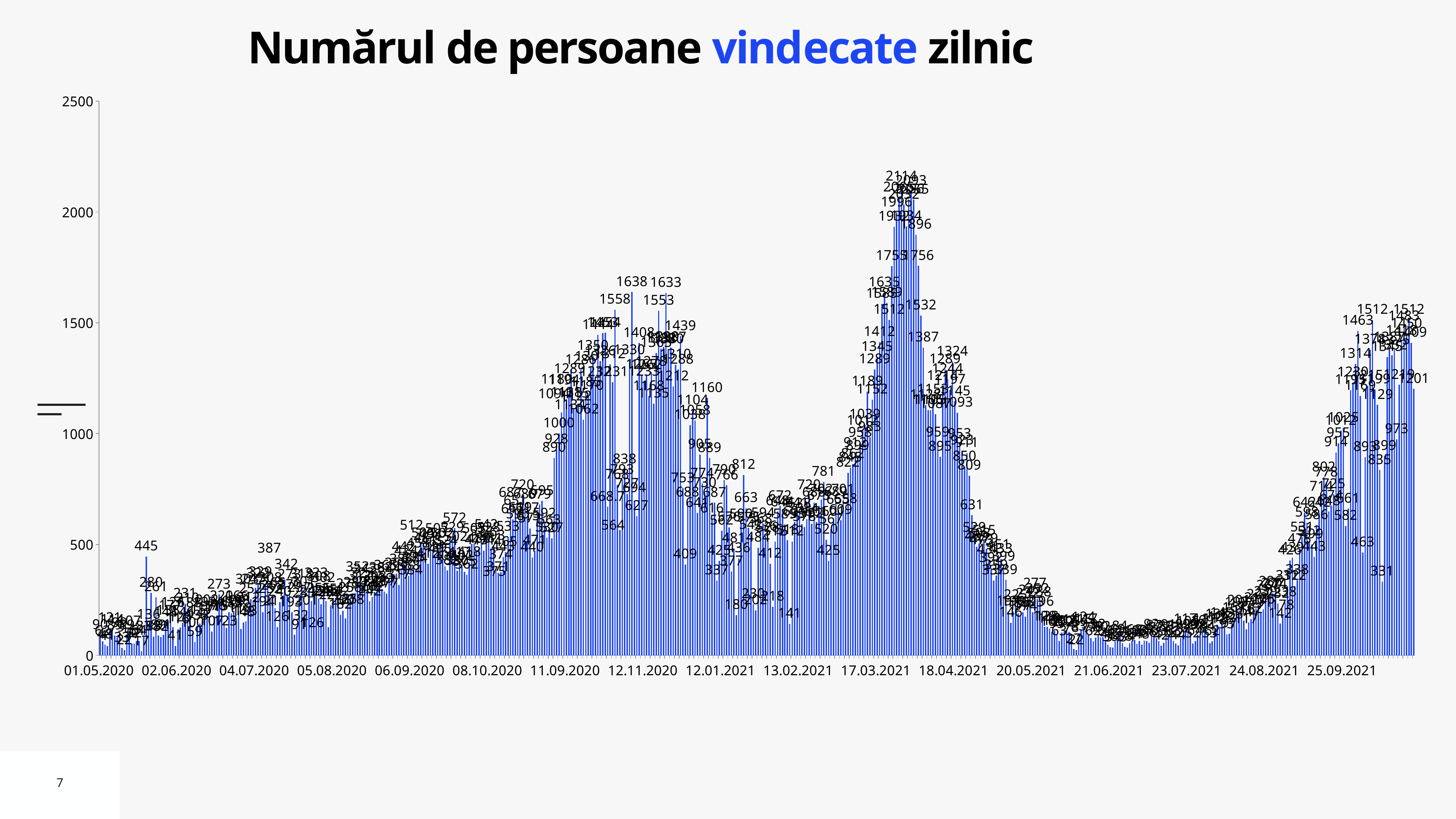
What is the title of the chart? Numărul de persoane vindecate zilnic Do the values rise or fall from 21.06.2021 to 25.09.2021? rise Which peak is higher: the one around 12.11.2020 or the one between 17.03.2021 and 18.04.2021? the one between 17.03.2021 and 18.04.2021 What kind of chart is shown on the slide? bar chart What is the highest labeled value between 01.05.2020 and 02.06.2020? 445 What is the highest value shown on the vertical axis? 2500 What is the highest data label shown on the chart? 2114 How many date labels are shown on the horizontal axis? 17 Is the value for the first bar at 01.05.2020 greater or less than 500? less Is the highest bar, in the peak between 17.03.2021 and 18.04.2021, greater or less than 2000? greater